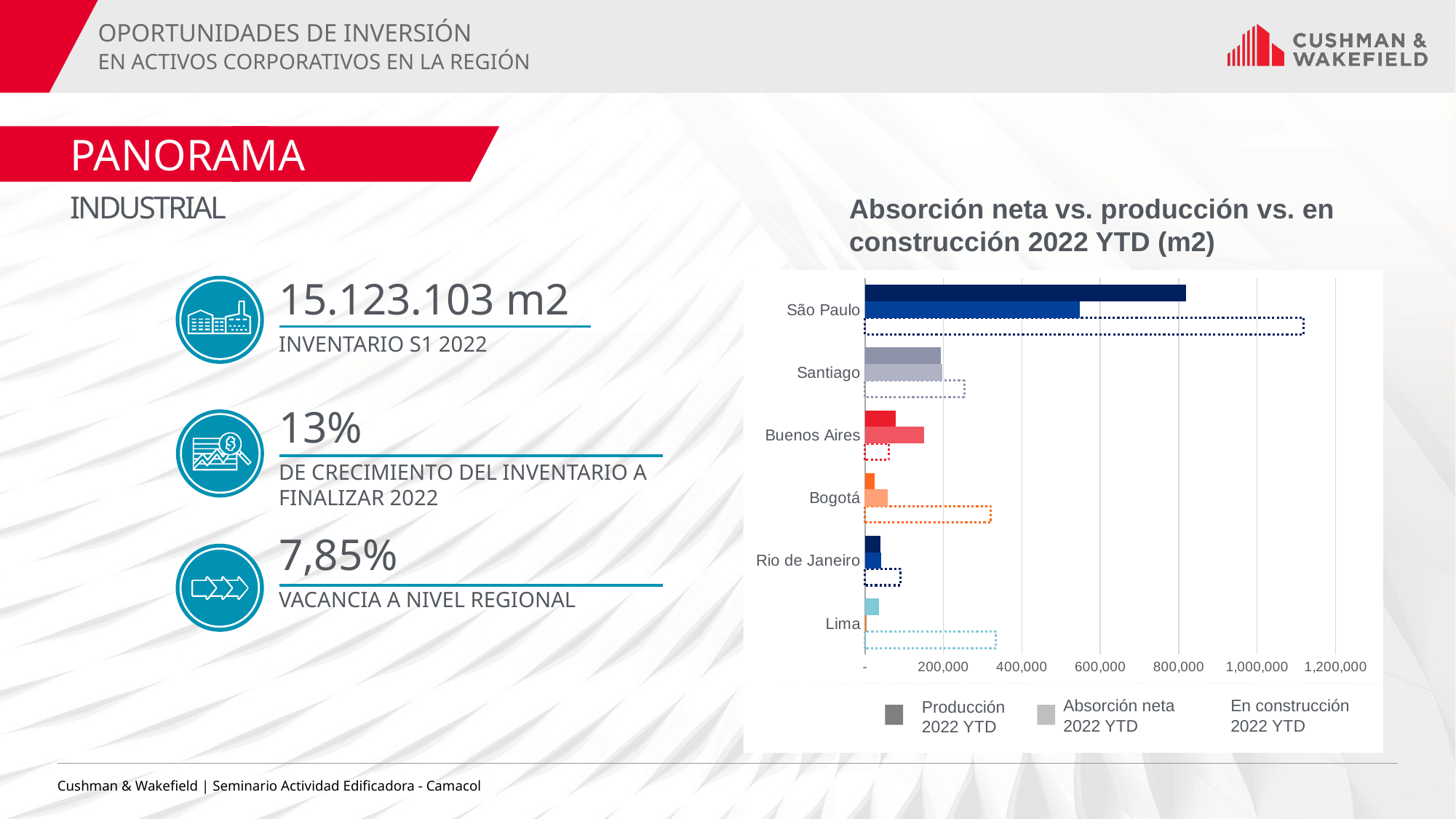
For Bogotá, which is larger: Producción 2022 YTD or En construcción 2022 YTD? En construcción 2022 YTD Is the Absorción neta 2022 YTD value for Buenos Aires greater or less than 200,000? less How many cities are shown on the chart? 6 Which city has the highest Producción 2022 YTD value? São Paulo Is the Producción 2022 YTD value for São Paulo greater or less than 600,000? greater What kind of chart is shown on the slide? bar chart Is the En construcción 2022 YTD value for São Paulo greater or less than 1,000,000? greater For São Paulo, which is larger: Producción 2022 YTD or Absorción neta 2022 YTD? Producción 2022 YTD How many series does the chart legend list? 3 Which city has the lowest Producción 2022 YTD value? Bogotá What is the title of the chart? Absorción neta vs. producción vs. en construcción 2022 YTD (m2)